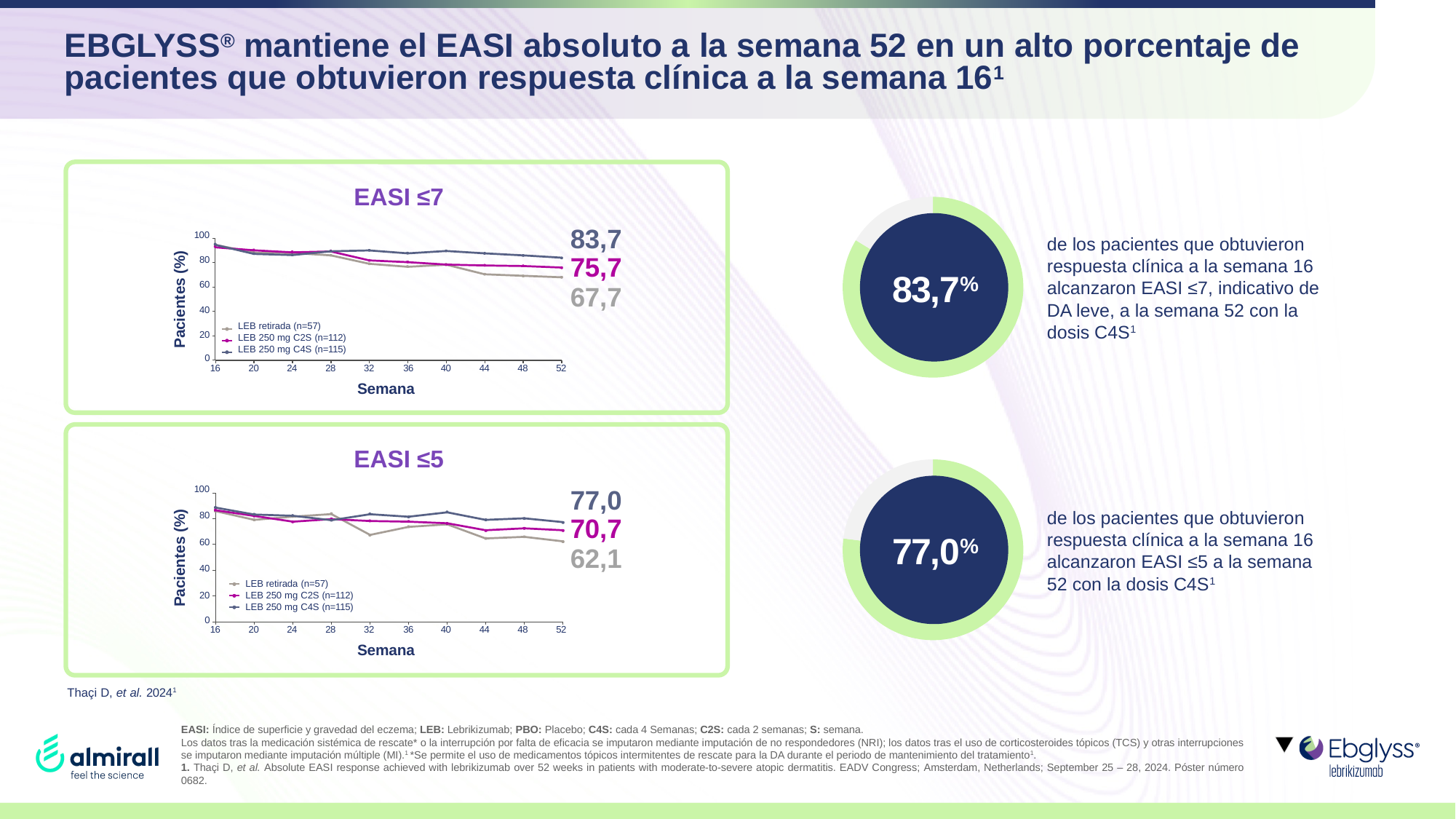
How many series does the legend of the EASI ≤5 chart list? 3 What kind of chart is the EASI ≤7 chart? Line chart In the EASI ≤5 chart, what is the value for LEB 250 mg C2S (n=112) at week 52? 70,7 In the EASI ≤7 chart, what is the value for LEB 250 mg C4S (n=115) at week 52? 83,7 In the EASI ≤5 chart, what is the difference between the week 52 values of LEB 250 mg C4S (n=115) and LEB 250 mg C2S (n=112)? 6,3 In the EASI ≤7 chart, which series has the highest value at week 52? LEB 250 mg C4S (n=115) In the EASI ≤5 chart, which is larger at week 52: LEB 250 mg C2S (n=112) or LEB retirada (n=57)? LEB 250 mg C2S (n=112) In the EASI ≤7 chart, what is the value for LEB retirada (n=57) at week 52? 67,7 In the EASI ≤5 chart, which series has the lowest value at week 52? LEB retirada (n=57) In the EASI ≤7 chart, does the LEB retirada (n=57) line rise or fall from week 16 to week 52? Fall In the EASI ≤7 chart, what is the difference between the week 52 values of LEB 250 mg C4S (n=115) and LEB retirada (n=57)? 16,0 In the EASI ≤7 chart, is the value for LEB retirada (n=57) at week 16 greater or less than 80? greater